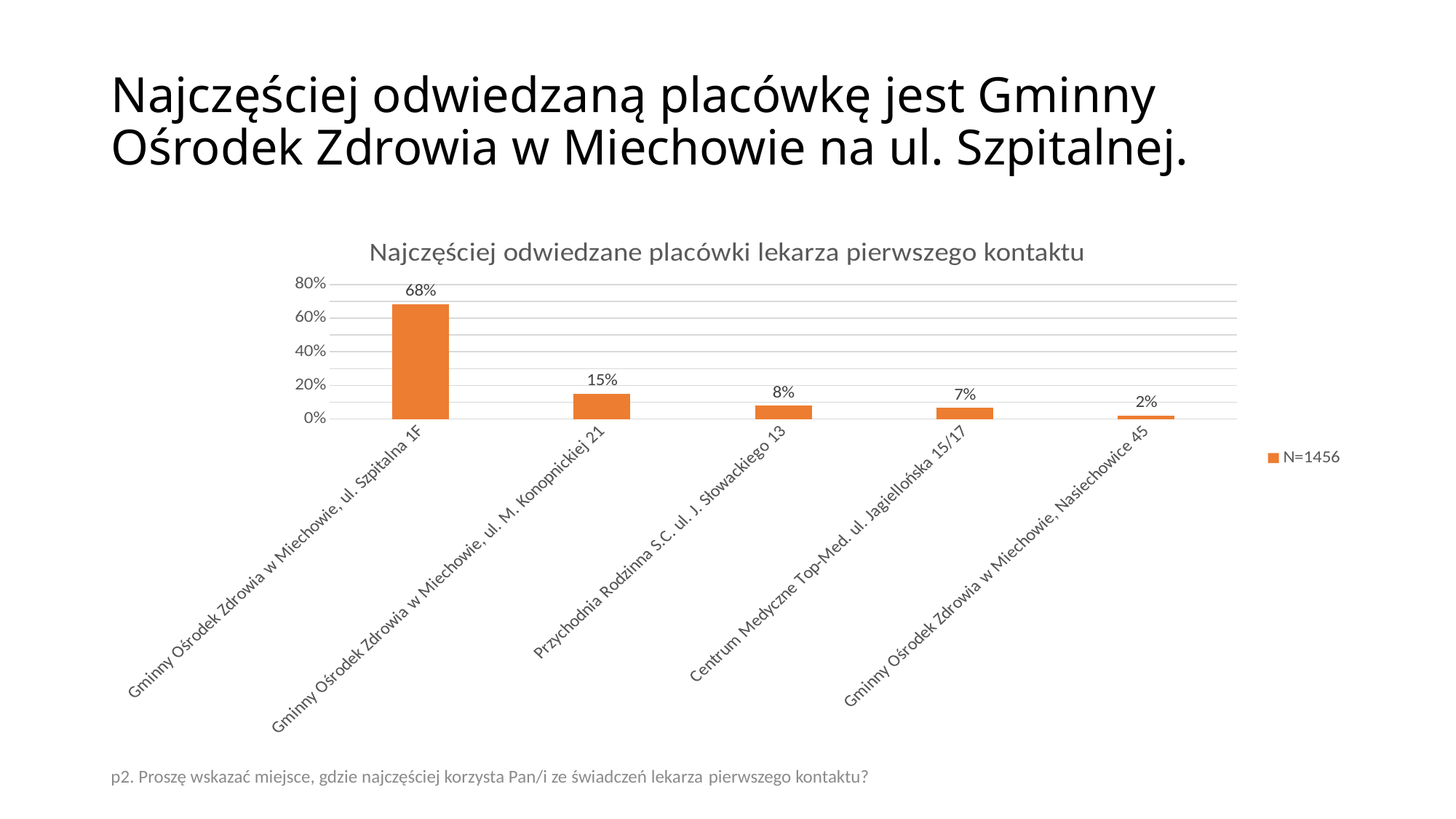
What is the value for Przychodnia Rodzinna S.C. ul. J. Słowackiego 13? 8% What is the difference between the values for ul. Szpitalna 1F and ul. M. Konopnickiej 21? 53% What is the value for Gminny Ośrodek Zdrowia w Miechowie, ul. M. Konopnickiej 21? 15% What is the value for Centrum Medyczne Top-Med. ul. Jagiellońska 15/17? 7% What is the value for Gminny Ośrodek Zdrowia w Miechowie, ul. Szpitalna 1F? 68% What is the legend entry shown on the chart? N=1456 What kind of chart is shown on the slide? Bar chart Which is larger: the value for Przychodnia Rodzinna S.C. ul. J. Słowackiego 13 or for Gminny Ośrodek Zdrowia w Miechowie, Nasiechowice 45? Przychodnia Rodzinna S.C. ul. J. Słowackiego 13 Which category has the highest value? Gminny Ośrodek Zdrowia w Miechowie, ul. Szpitalna 1F Which category has the lowest value? Gminny Ośrodek Zdrowia w Miechowie, Nasiechowice 45 How many categories are shown on the chart? 5 What is the value for Gminny Ośrodek Zdrowia w Miechowie, Nasiechowice 45? 2%